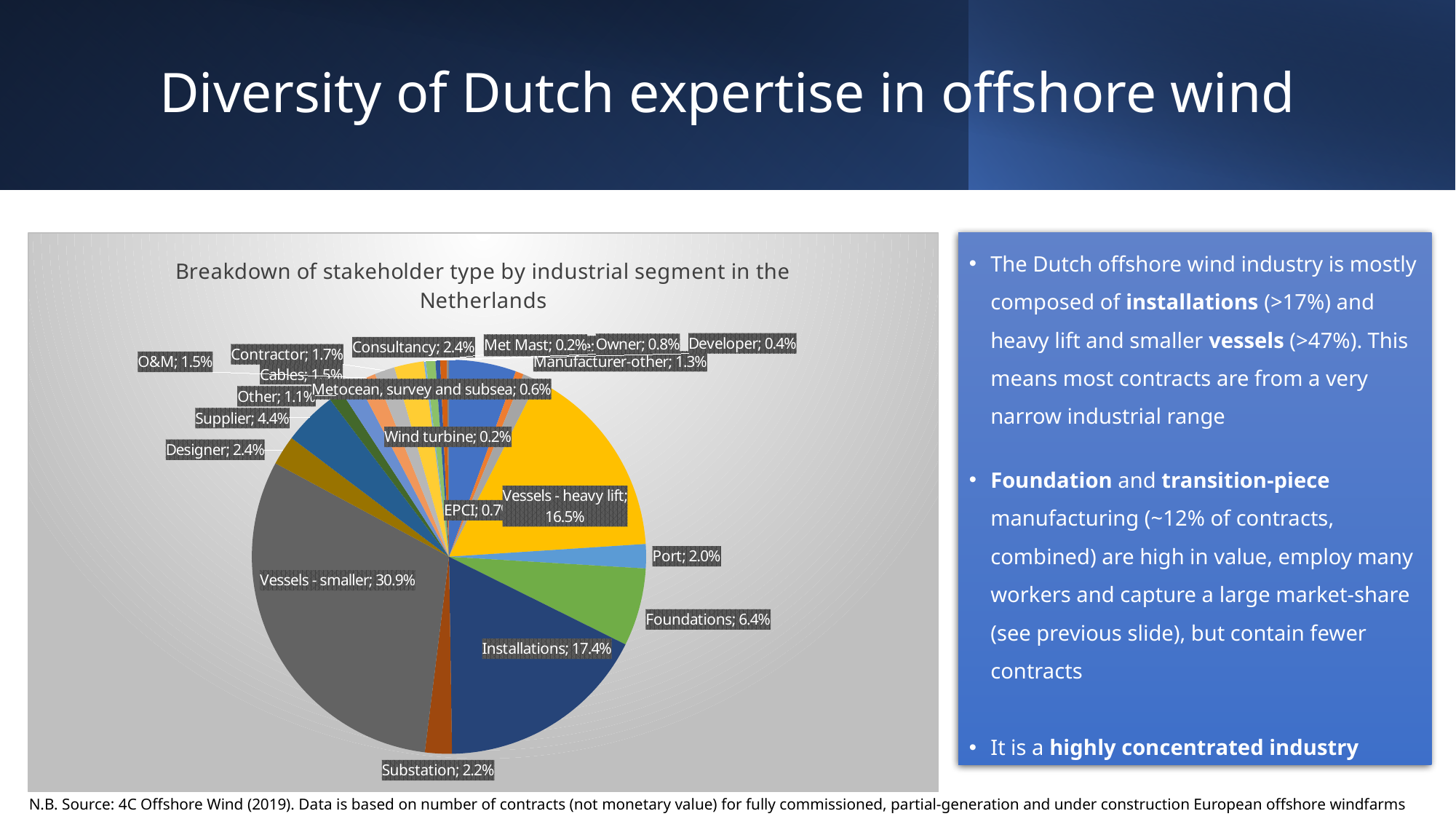
What share of the pie is Supplier? 4.4% What share of the pie is Substation? 2.2% What share of the pie is Foundations? 6.4% What is the combined share of Vessels - smaller and Vessels - heavy lift? 47.4% What is the difference between the shares of Vessels - smaller and Installations? 13.5% Which segment has the largest share of the pie? Vessels - smaller Which is larger, the share for Installations or the share for Vessels - heavy lift? Installations What share of the pie is Vessels - heavy lift? 16.5% What share of the pie is Port? 2.0% What kind of chart is shown on the slide? pie chart What share of the pie is Installations? 17.4% What is the title of the chart? Breakdown of stakeholder type by industrial segment in the Netherlands